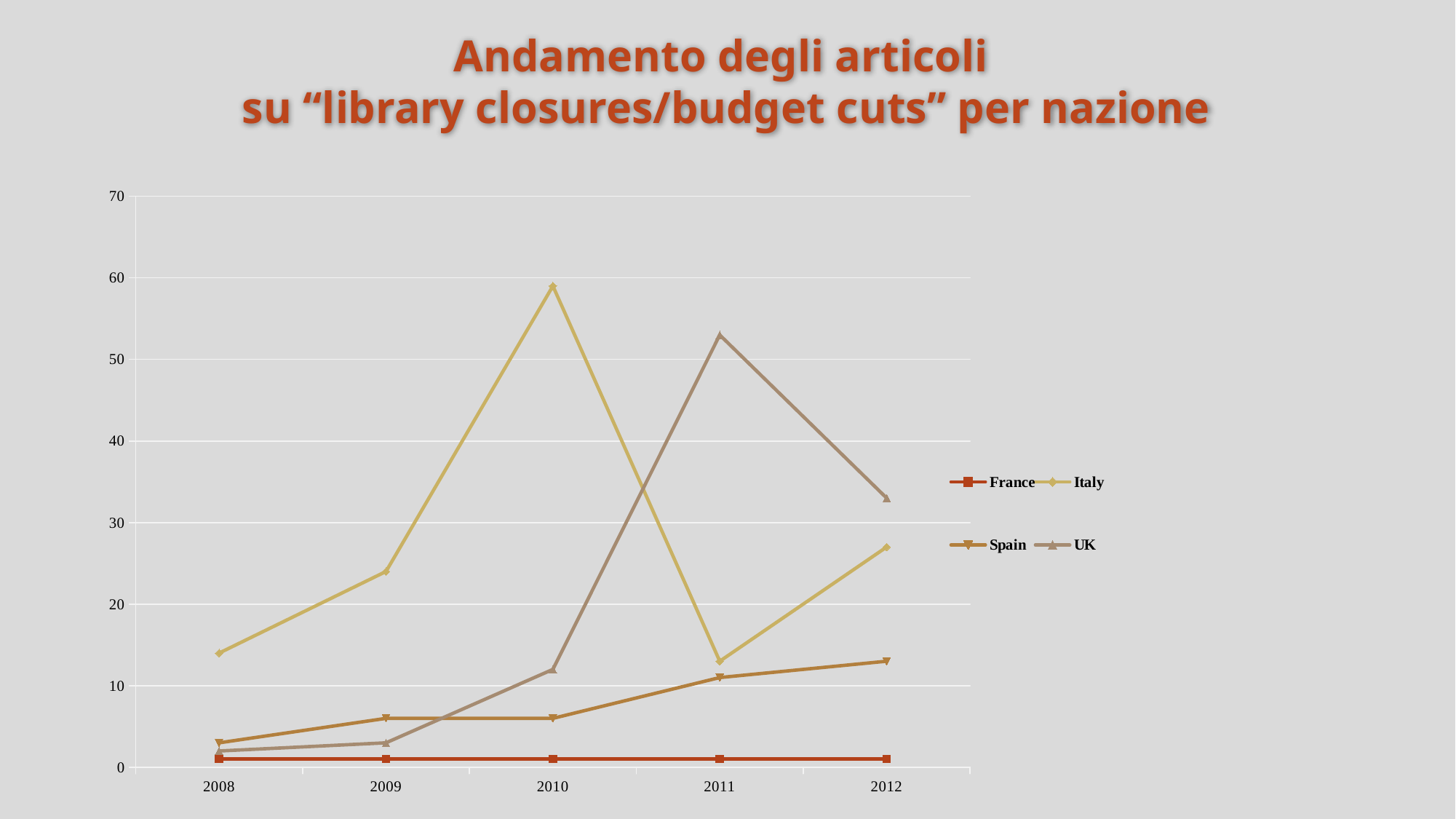
Is the value for UK in 2011 greater or less than 40? greater In 2012, which is larger: the value for Italy or the value for UK? UK Does the Spain line rise or fall from 2008 to 2012? rises What kind of chart is shown on the slide? line chart Which country has the highest value in 2011? UK Does the UK line rise or fall from 2011 to 2012? falls Which country has the highest value in 2010? Italy How many series does the legend list? 4 How many years are shown along the x axis? 5 Which country has the lowest values across all years? France Is the value for Spain in 2012 greater or less than 20? less Is the value for Italy in 2010 greater or less than 50? greater